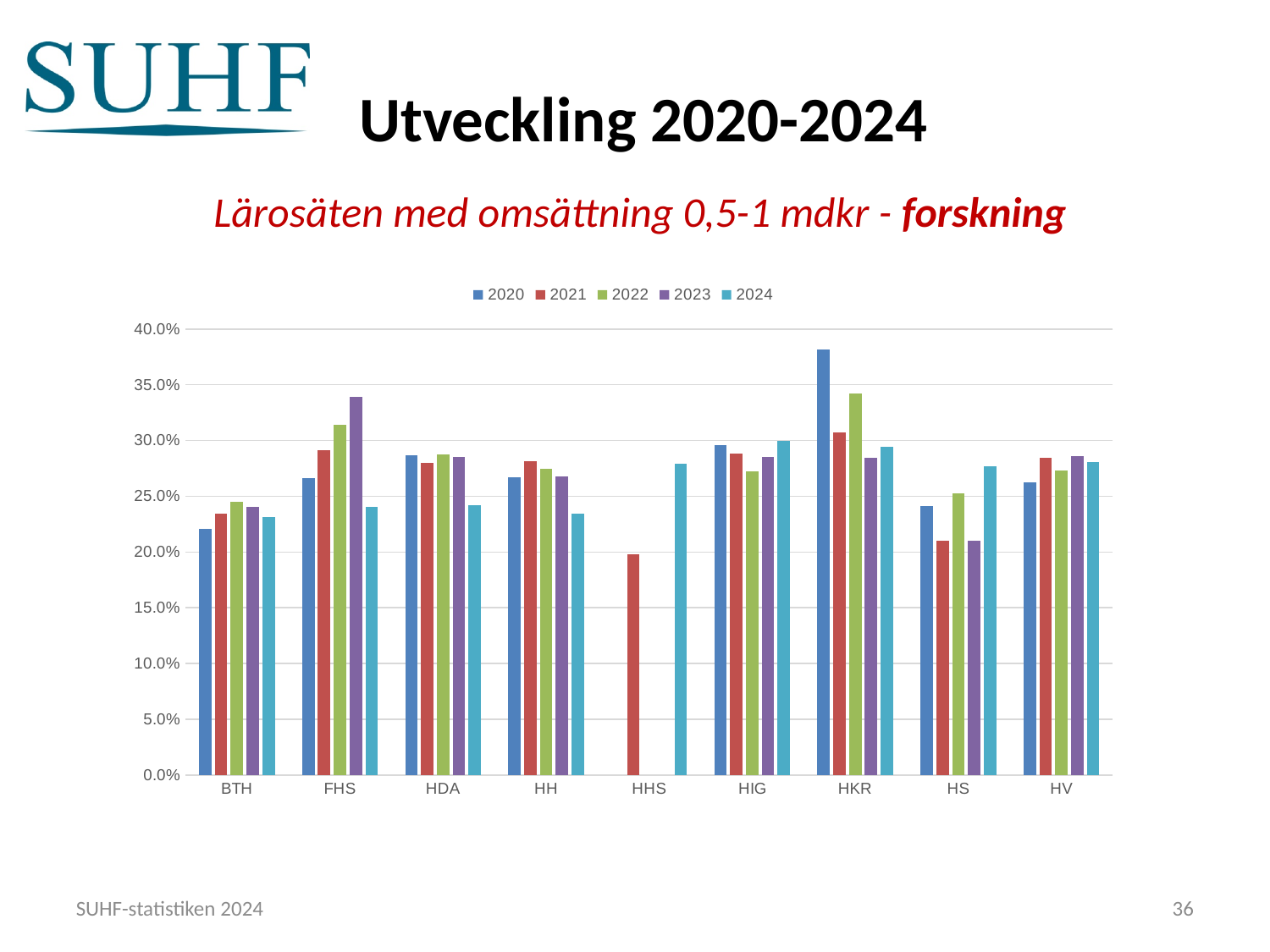
What is the subtitle of the chart shown on the slide? Lärosäten med omsättning 0,5-1 mdkr - forskning What kind of chart is shown on the slide? bar chart How many categories are shown on the x axis? 9 Is the value for FHS in 2023 greater or less than 30.0%? greater Is the value for BTH in 2020 greater or less than 25.0%? less How many series does the legend list? 5 For HS, which year has the larger value, 2021 or 2024? 2024 For FHS, which year has the larger value, 2023 or 2024? 2023 Is the value for HHS in 2021 greater or less than 25.0%? less Which category has bars for only two of the years? HHS Which category and year has the highest bar in the chart? HKR, 2020